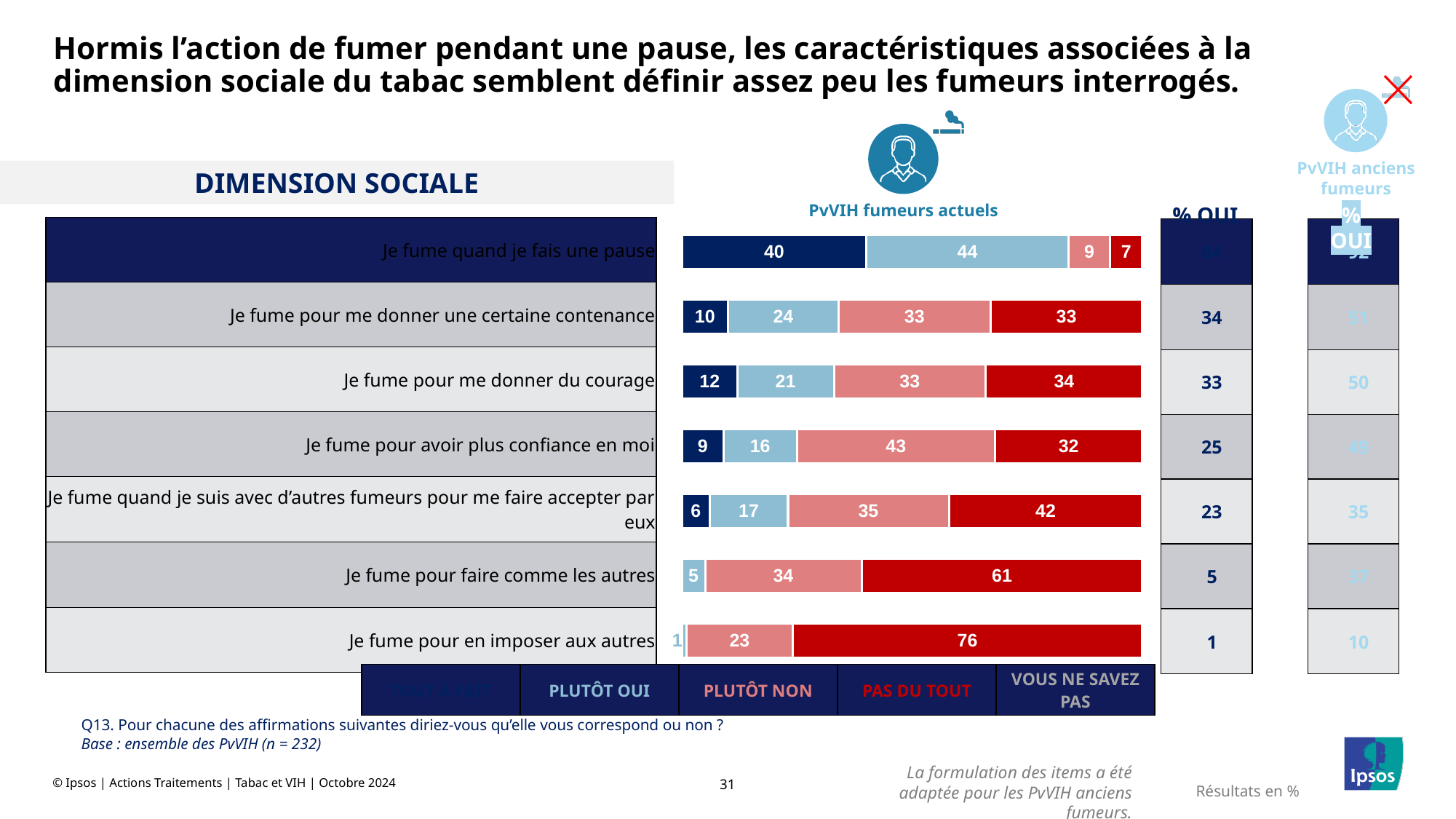
How many response categories does the legend below the chart list? 5 Which has the larger 'Plutôt non' value: 'Je fume pour avoir plus confiance en moi' or 'Je fume pour me donner du courage'? Je fume pour avoir plus confiance en moi What is the 'Pas du tout' value for 'Je fume pour en imposer aux autres'? 76 What is the difference between the 'Pas du tout' values for 'Je fume pour en imposer aux autres' and 'Je fume pour faire comme les autres'? 15 What kind of chart is shown on the slide? Stacked bar chart What is the '% OUI' value for 'Je fume pour me donner une certaine contenance' among PvVIH fumeurs actuels? 34 Which statement has the lowest '% OUI' value among PvVIH fumeurs actuels? Je fume pour en imposer aux autres What is the total of the stacked bar for 'Je fume pour me donner du courage'? 100 Which statement has the highest 'Pas du tout' value? Je fume pour en imposer aux autres What is the 'Plutôt oui' value for 'Je fume quand je fais une pause'? 44 How many statements (categories) are plotted in the chart? 7